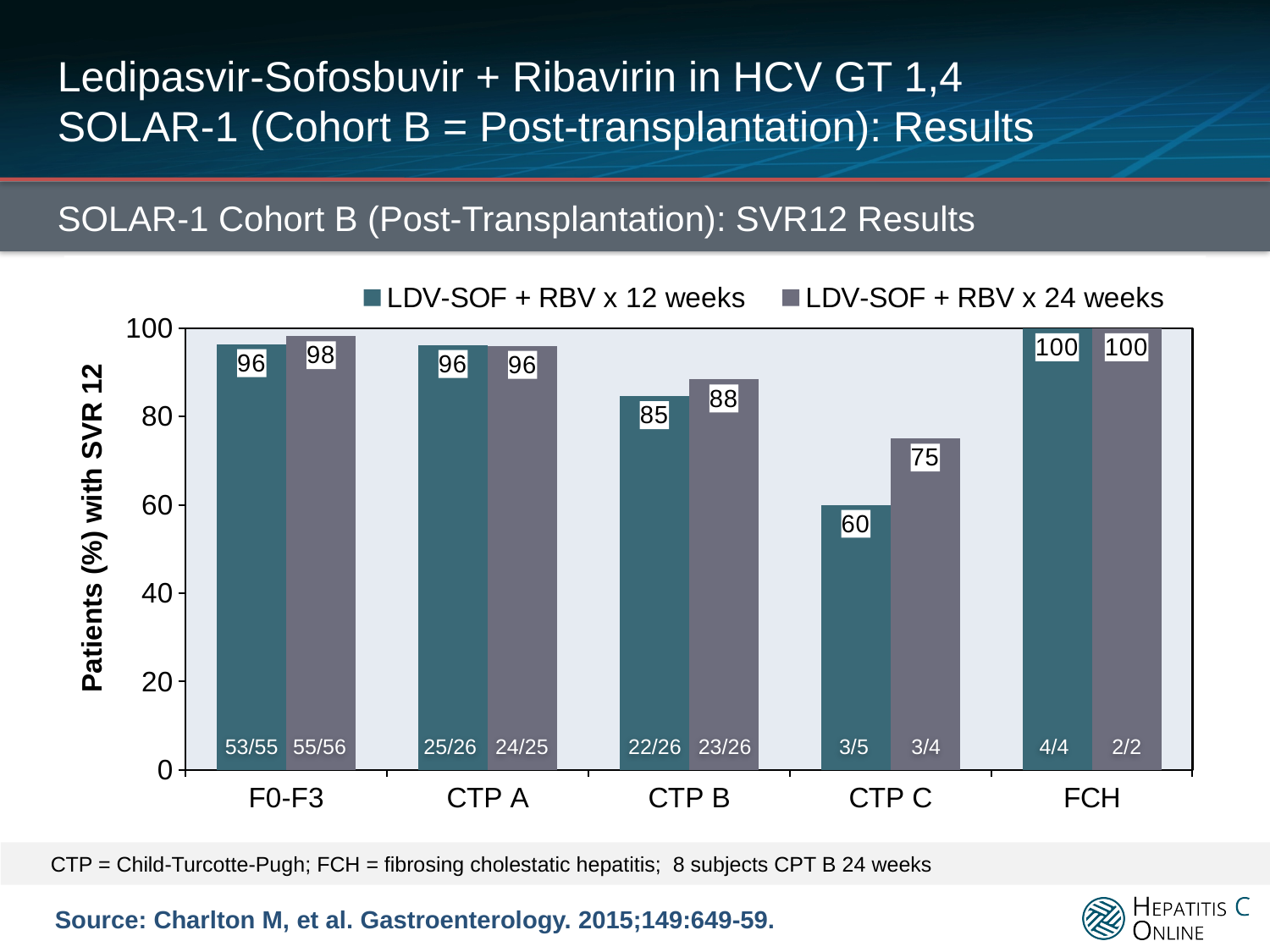
What is the difference between the 24-week and 12-week SVR12 rates for CTP C patients? 15 What is the fraction of patients achieving SVR12 shown at the base of the CTP A 12-week bar? 25/26 What is the SVR12 rate for F0-F3 patients treated with LDV-SOF + RBV x 24 weeks? 98 What is the SVR12 rate for CTP C patients treated with LDV-SOF + RBV x 12 weeks? 60 What is the SVR12 rate for CTP B patients treated with LDV-SOF + RBV x 24 weeks? 88 How many series does the legend list? 2 How many patient categories are shown on the x axis? 5 What is the label of the y axis? Patients (%) with SVR 12 What kind of chart is shown on the slide? Bar chart Which category has the lowest SVR12 rate for the LDV-SOF + RBV x 12 weeks series? CTP C Which category has the highest SVR12 rate for the LDV-SOF + RBV x 24 weeks series? FCH For CTP B patients, which treatment duration had the higher SVR12 rate, 12 weeks or 24 weeks? 24 weeks